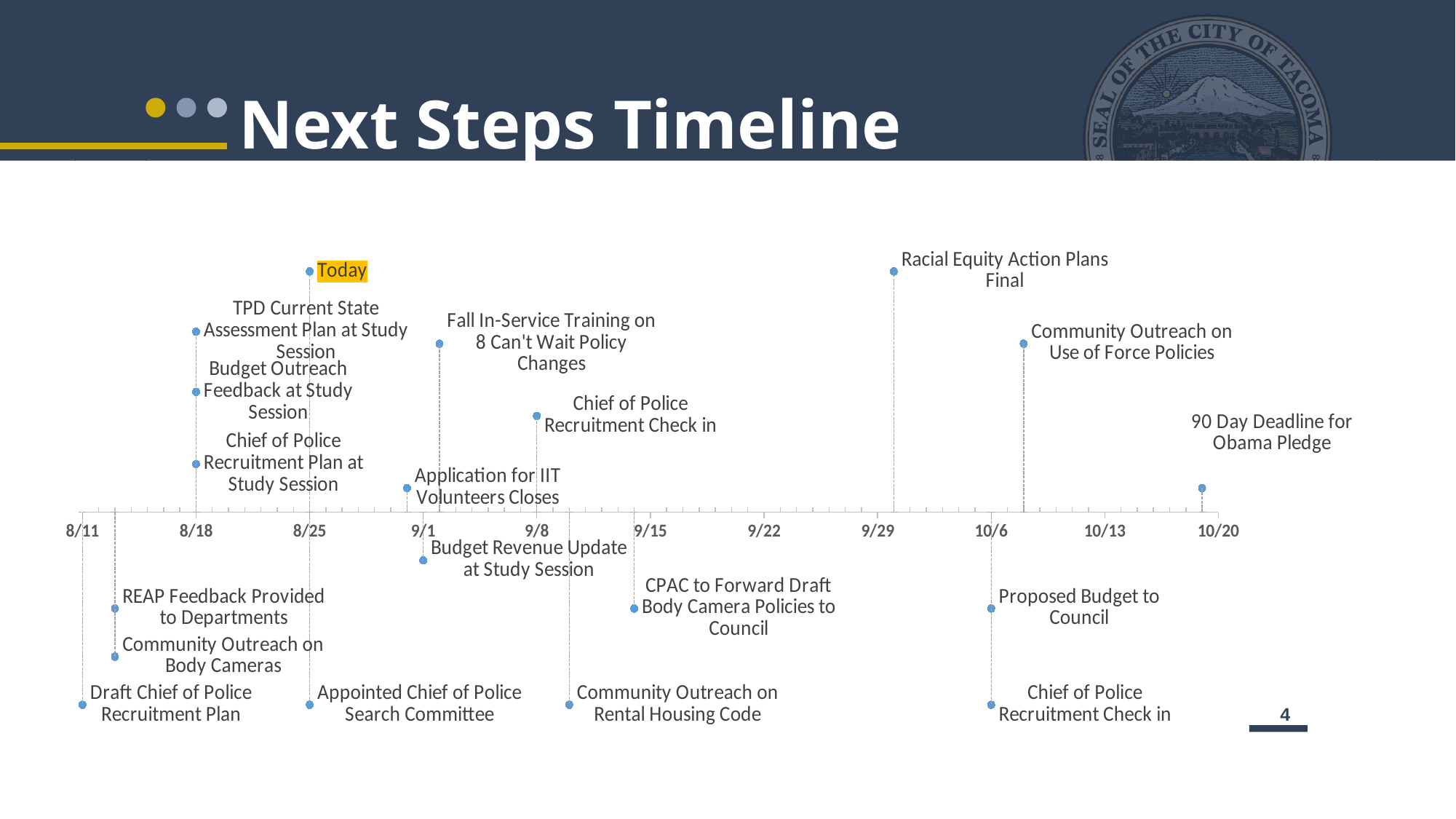
Which event is the earliest on the timeline? Draft Chief of Police Recruitment Plan Which event is the latest on the timeline? 90 Day Deadline for Obama Pledge What is the title of the chart on the slide? Next Steps Timeline Which event label on the timeline is highlighted in yellow? Today On what date is 'Draft Chief of Police Recruitment Plan' placed on the timeline? 8/11 Is 'Community Outreach on Use of Force Policies' placed before or after 10/6 on the timeline? after On what date is 'Appointed Chief of Police Search Committee' placed on the timeline? 8/25 What kind of chart is shown on the slide? timeline Which comes earlier on the timeline, 'Racial Equity Action Plans Final' or 'Proposed Budget to Council'? Racial Equity Action Plans Final How many date labels are shown along the timeline axis? 11 On what date is the 'Today' marker placed on the timeline? 8/25 On what date is 'Proposed Budget to Council' placed on the timeline? 10/6